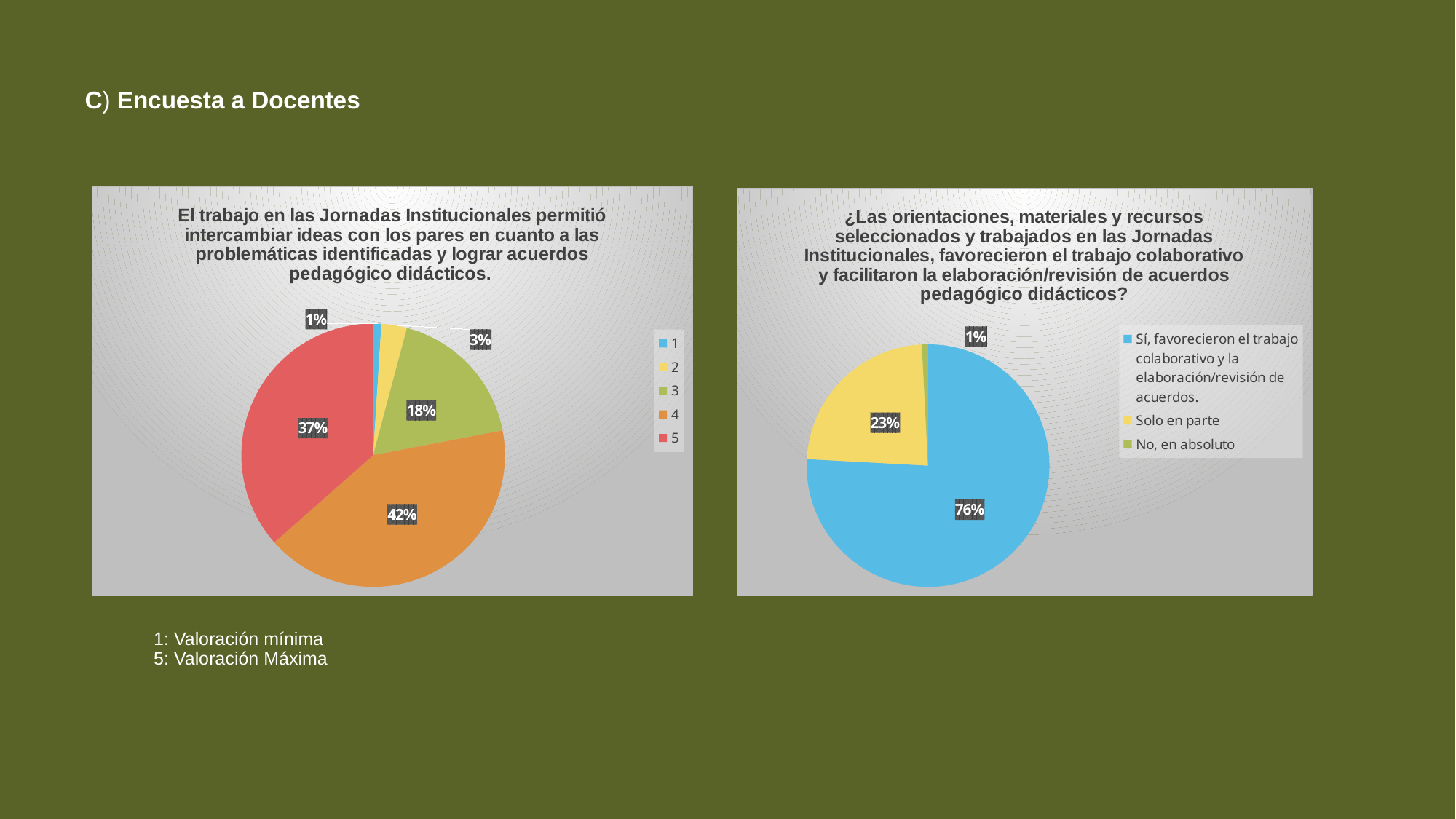
On the right pie chart, what percentage answered 'No, en absoluto'? 1% On the left pie chart, what percentage is shown for category 3? 18% On the left pie chart, which category has the smallest share? 1 On the left pie chart, which category has the largest share? 4 What type of chart is used on the right side of the slide? Pie chart On the left pie chart, which is larger, the share for category 3 or the share for category 5? 5 On the left pie chart, what is the difference between the shares of category 4 and category 5? 5% How many categories does the legend of the left pie chart list? 5 On the left pie chart, what percentage is shown for category 4? 42% On the right pie chart, what is the difference between the 'Sí' share and the 'Solo en parte' share? 53% On the right pie chart, which response has the largest share? Sí, favorecieron el trabajo colaborativo y la elaboración/revisión de acuerdos. On the right pie chart, what percentage answered 'Solo en parte'? 23%